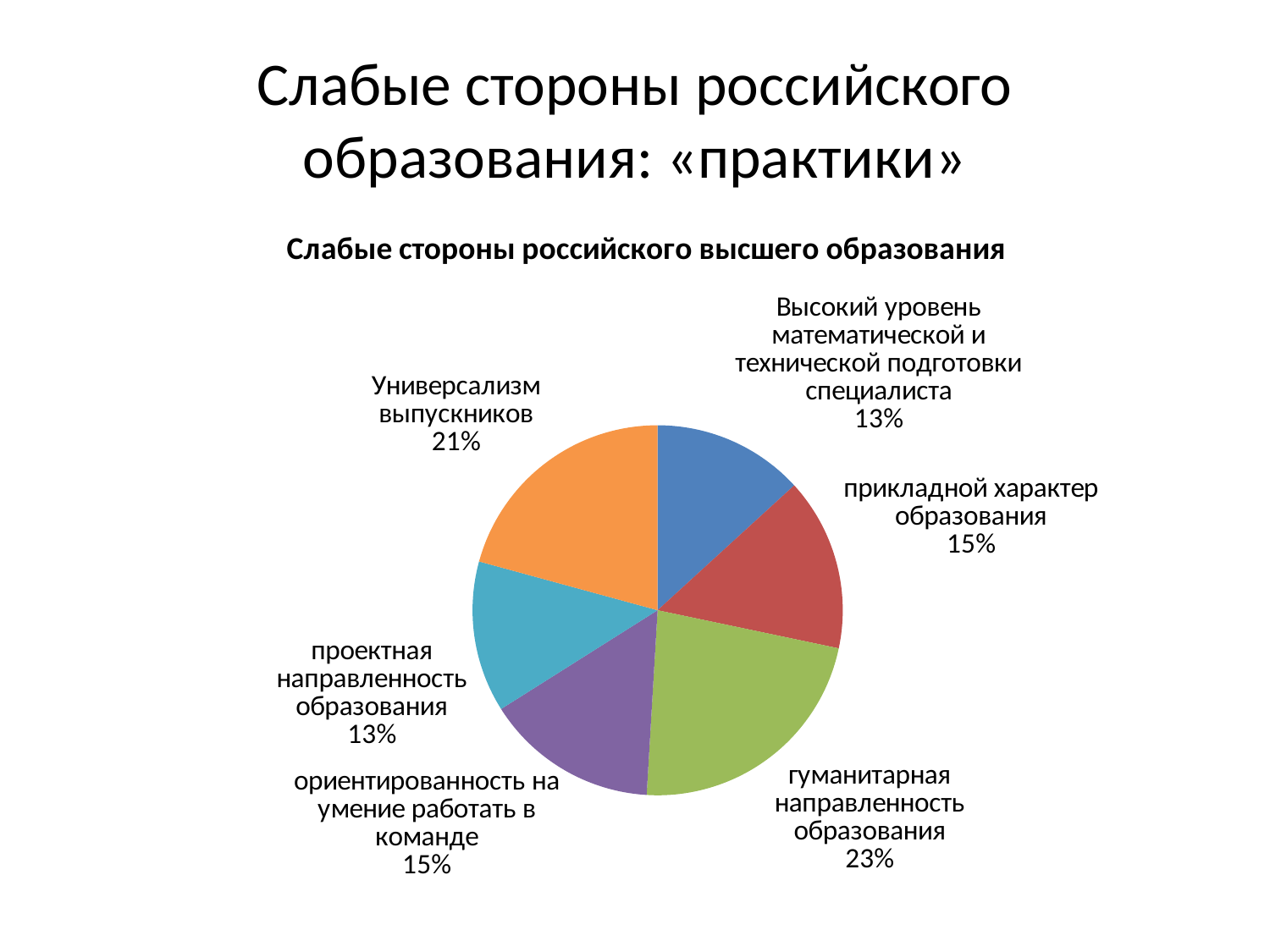
What share of the pie is labelled "гуманитарная направленность образования"? 23% What share of the pie is labelled "проектная направленность образования"? 13% What colour is the slice for "Универсализм выпускников"? orange Which is larger: the share for "Универсализм выпускников" or the share for "гуманитарная направленность образования"? гуманитарная направленность образования What share of the pie is labelled "ориентированность на умение работать в команде"? 15% Which category has the largest share of the pie? гуманитарная направленность образования How many slices does the pie chart have? 6 What is the difference in percentage points between the share for "гуманитарная направленность образования" and the share for "проектная направленность образования"? 10 What is the title of the chart? Слабые стороны российского высшего образования What kind of chart is shown on the slide? pie chart